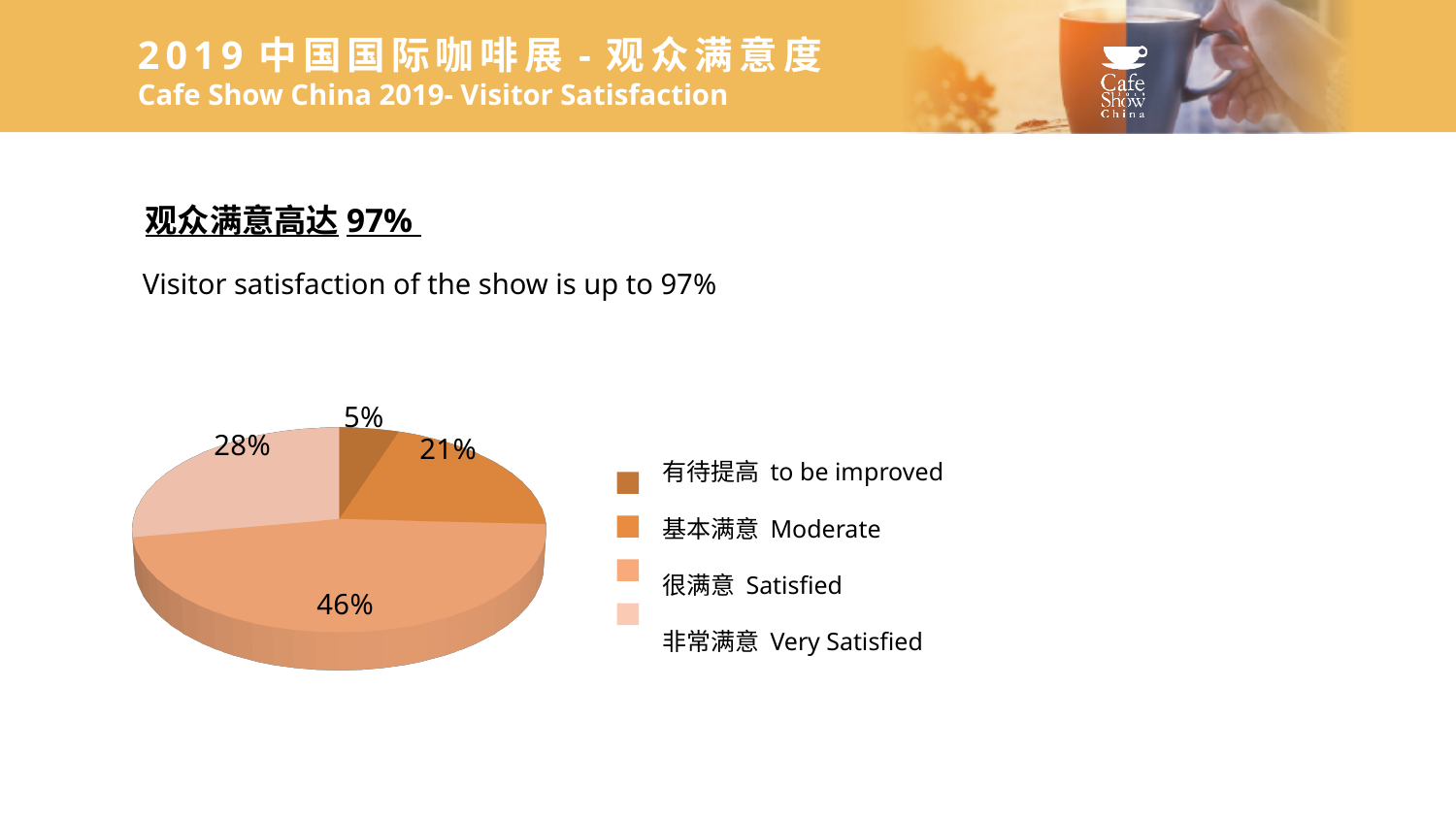
What share of the pie is labelled Very Satisfied (非常满意)? 28% What is the combined share of Moderate, Satisfied and Very Satisfied? 95% What share of the pie is labelled 'to be improved' (有待提高)? 5% Which is larger, the Moderate share or the Very Satisfied share? Very Satisfied How many slices does the pie chart have? 4 What is the difference between the Satisfied share and the Very Satisfied share? 18% What kind of chart is shown on the slide? pie chart How many entries does the legend list? 4 Which category has the largest slice of the pie? Satisfied What share of the pie is labelled Satisfied (很满意)? 46% Which category has the smallest slice of the pie? to be improved